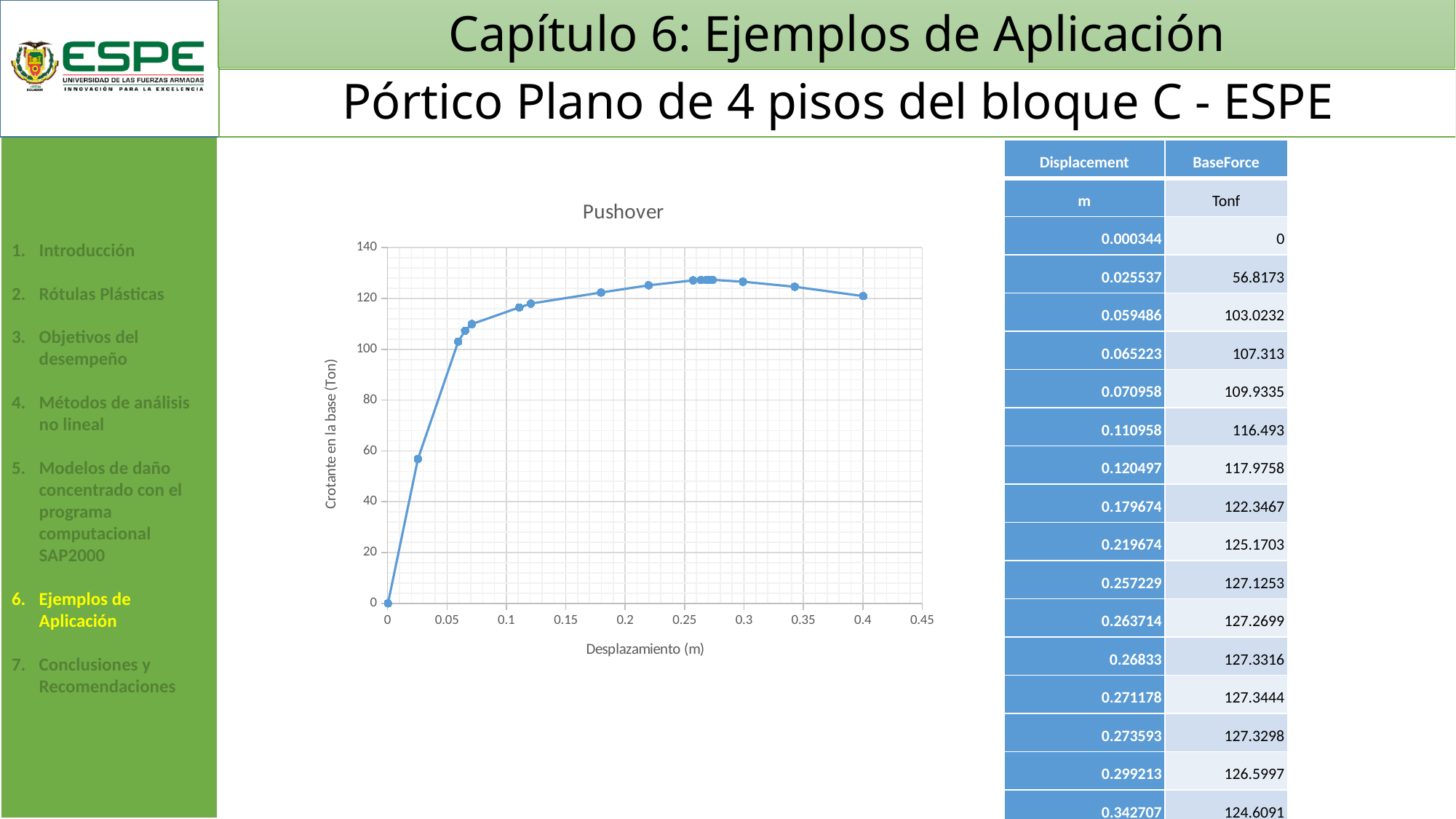
In the Pushover chart, is the value at a displacement of 0.3 m greater or less than 120? greater In the Pushover chart, do the values rise or fall as displacement increases from 0.3 m to 0.4 m? fall In the Pushover chart, is the value at a displacement of about 0.025 m greater or less than 80? less In the Pushover chart, which is larger: the value at a displacement of about 0.025 m or the value at 0.3 m? 0.3 m In the Pushover chart, what is the base shear value at a displacement of 0 m? 0 In the Pushover chart, do the values rise or fall as displacement increases from 0 to 0.1 m? rise What is the title of the chart? Pushover According to the table next to the chart, what is the BaseForce at a displacement of 0.059486 m? 103.0232 What is the label of the x axis of the Pushover chart? Desplazamiento (m) What kind of chart is shown on the slide? line chart In the Pushover chart, is the value at a displacement of about 0.18 m greater or less than 100? greater In the Pushover chart, at which displacement is the base shear lowest? 0